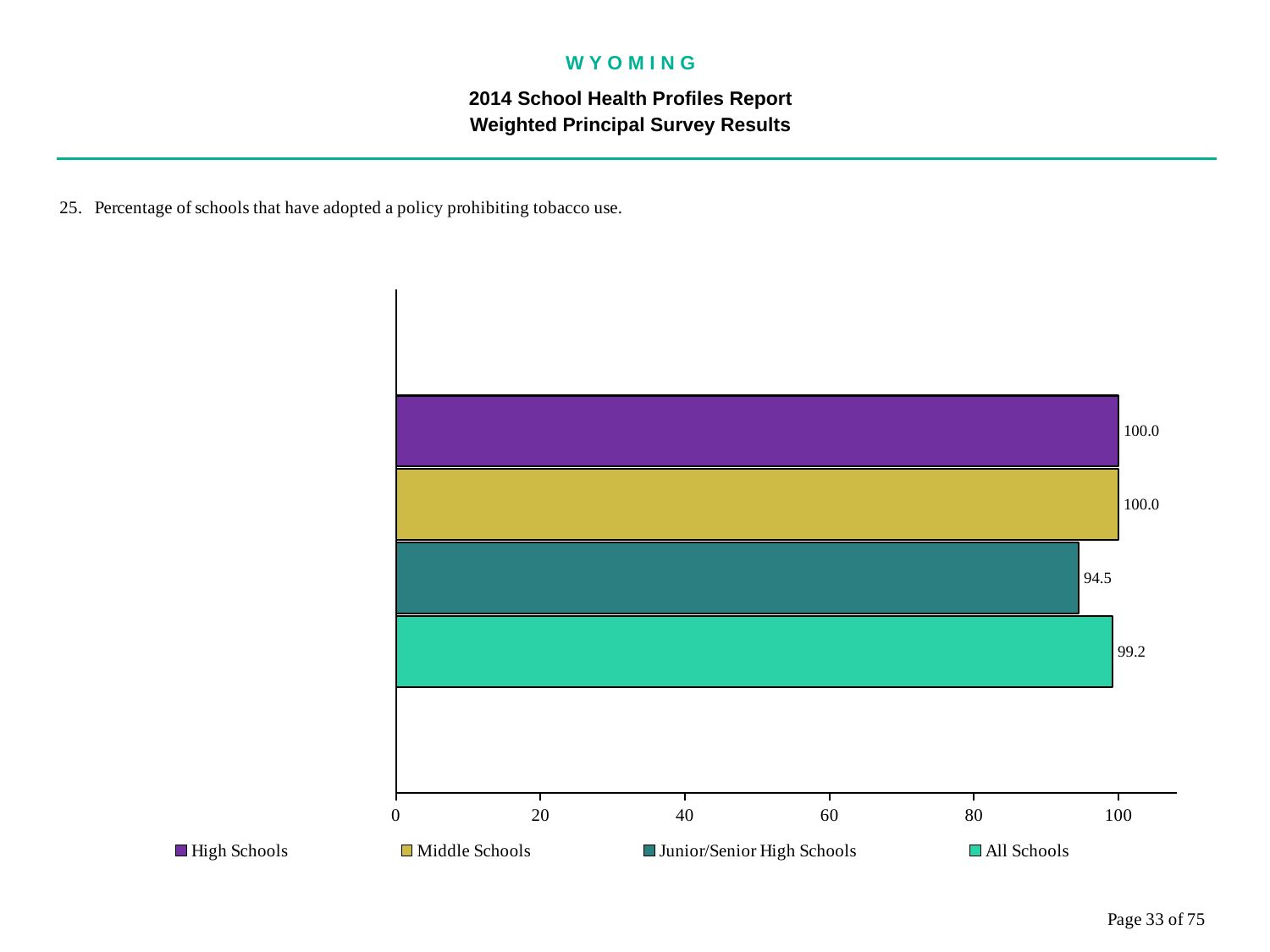
How many bars are shown in the chart? 4 What is the value for Junior/Senior High Schools? 94.5 What is the value for Middle Schools? 100.0 Is the value for Junior/Senior High Schools greater or less than 80? greater What is the difference between the values for All Schools and Junior/Senior High Schools? 4.7 What kind of chart is shown on the slide? bar chart Which category has the lowest value? Junior/Senior High Schools What is the value for All Schools? 99.2 What is the value for High Schools? 100.0 What is the difference between the values for High Schools and Junior/Senior High Schools? 5.5 Which is larger, the value for All Schools or the value for Junior/Senior High Schools? All Schools What colour is the bar for All Schools? green